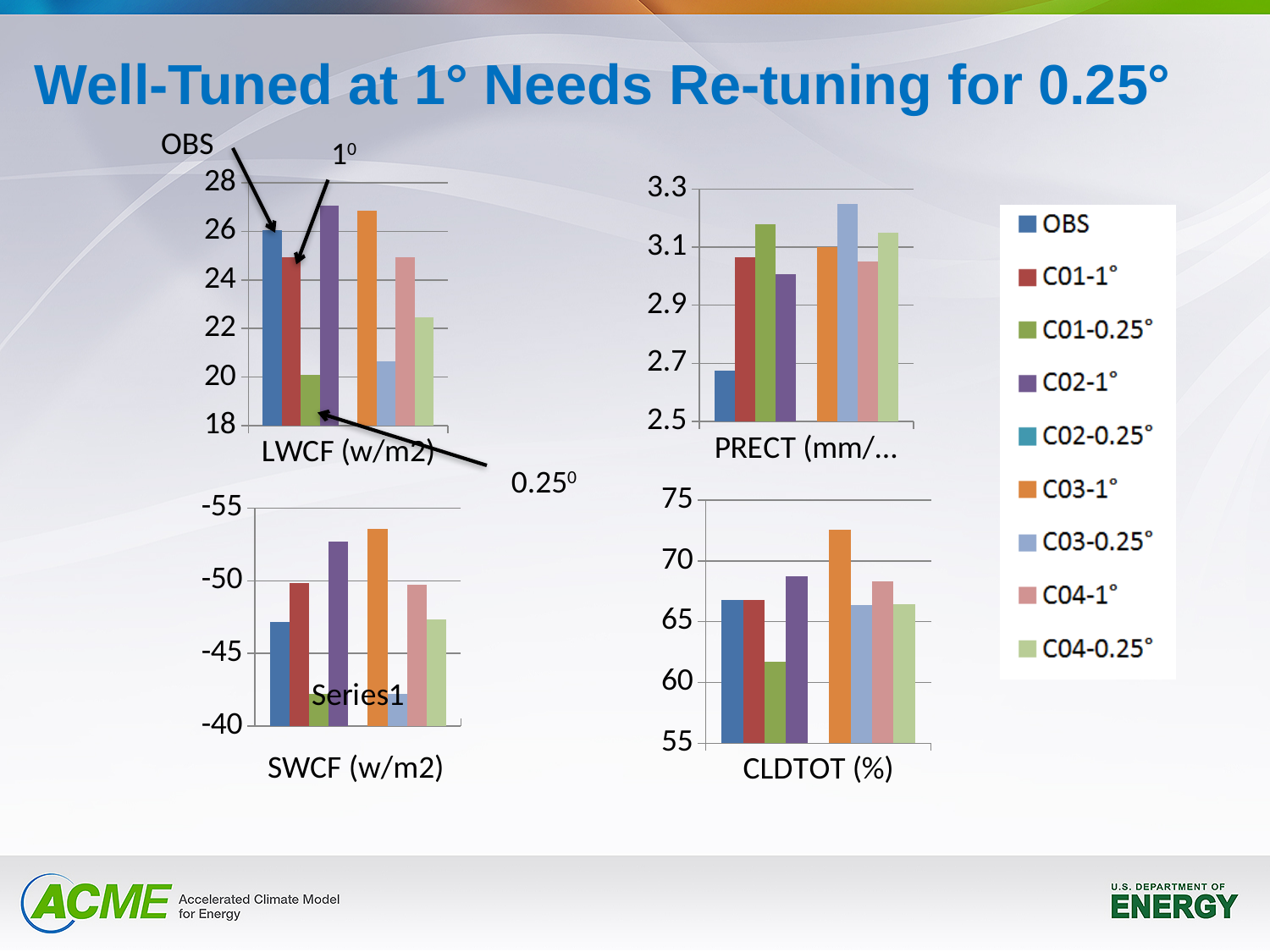
How many charts are shown on the slide? 4 In the LWCF (w/m2) chart, is the value for C01-0.25° greater or less than 22? less How many series does the legend on the slide list? 9 In the PRECT chart, which series has the lowest value? OBS What kind of chart is the LWCF (w/m2) chart? bar chart In the LWCF (w/m2) chart, which is larger, the value for C02-1° or the value for C01-0.25°? C02-1° In the PRECT chart, is the value for OBS greater or less than 2.7? less In the LWCF (w/m2) chart, is the value for OBS greater or less than 24? greater In the CLDTOT (%) chart, which series has the highest value? C03-1° In the CLDTOT (%) chart, which series has the lowest value? C01-0.25° In the PRECT chart, which series has the highest value? C03-0.25°